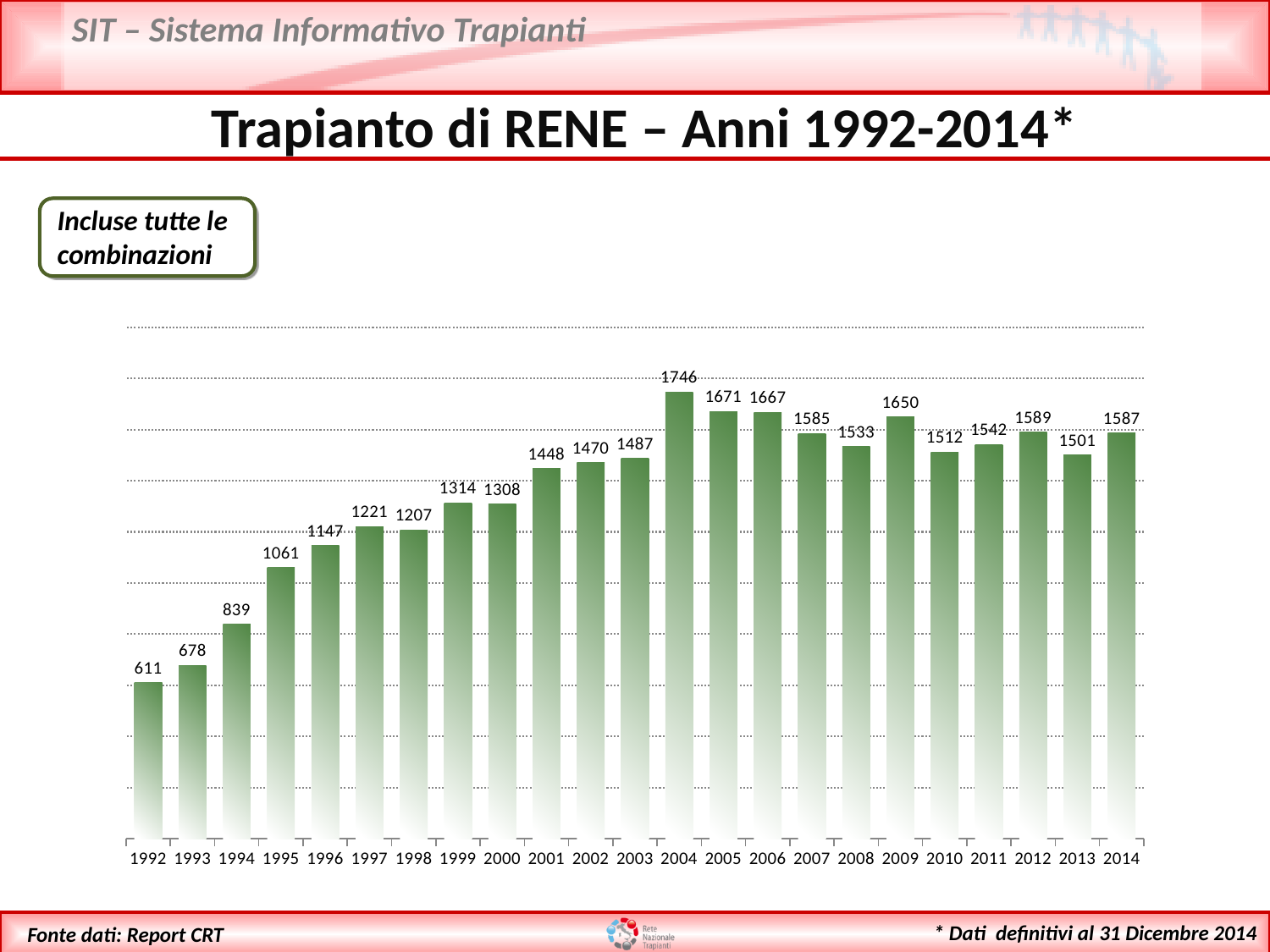
How many years are shown on the x axis? 23 Which is larger, the value for 2009 or the value for 2010? 2009 Which year has the lowest value? 1992 What is the value for 2004? 1746 What is the title of the chart? Trapianto di RENE – Anni 1992-2014* What is the value for 2014? 1587 What is the value for 1992? 611 What is the value for 1999? 1314 What is the difference between the values for 2014 and 1992? 976 Which year has the highest value? 2004 What is the difference between the values for 2004 and 2005? 75 What kind of chart is shown on the slide? Bar chart